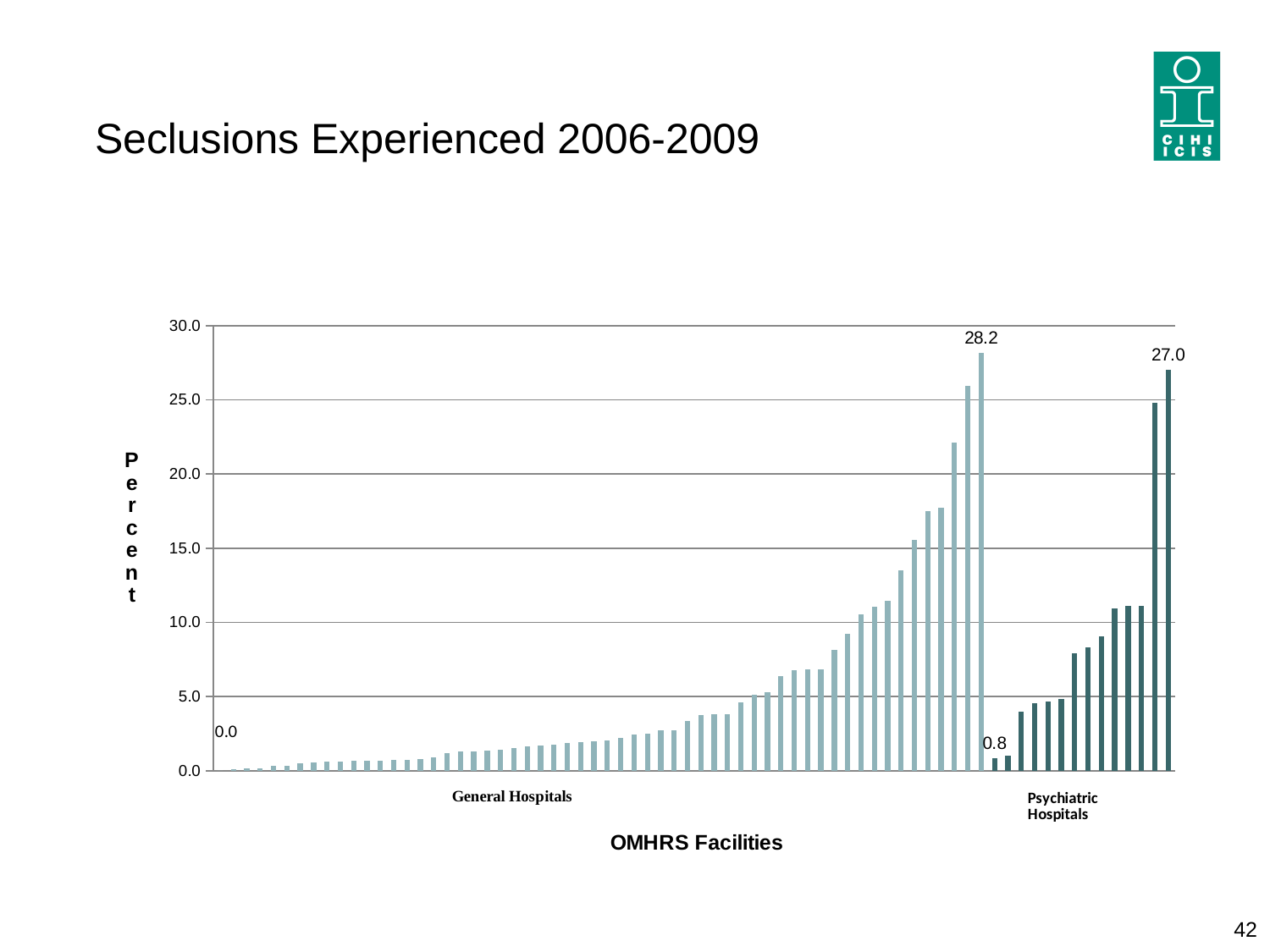
Is the tallest Psychiatric Hospitals bar greater or less than 25.0? greater What is the lowest seclusion percentage shown for Psychiatric Hospitals? 0.8 Which group contains the tallest bar on the chart, General Hospitals or Psychiatric Hospitals? General Hospitals What is the difference between the highest General Hospitals value (28.2) and the highest Psychiatric Hospitals value (27.0)? 1.2 What is the title of the x axis of the chart? OMHRS Facilities What is the lowest seclusion percentage shown for General Hospitals? 0.0 What is the difference between the lowest Psychiatric Hospitals value (0.8) and the lowest General Hospitals value (0.0)? 0.8 What kind of chart is shown on the slide? bar chart What is the highest seclusion percentage shown for Psychiatric Hospitals? 27.0 Which is larger: the highest General Hospitals value or the highest Psychiatric Hospitals value? the highest General Hospitals value Within the General Hospitals group, do the bar values rise or fall from left to right? rise What is the highest seclusion percentage shown for General Hospitals? 28.2